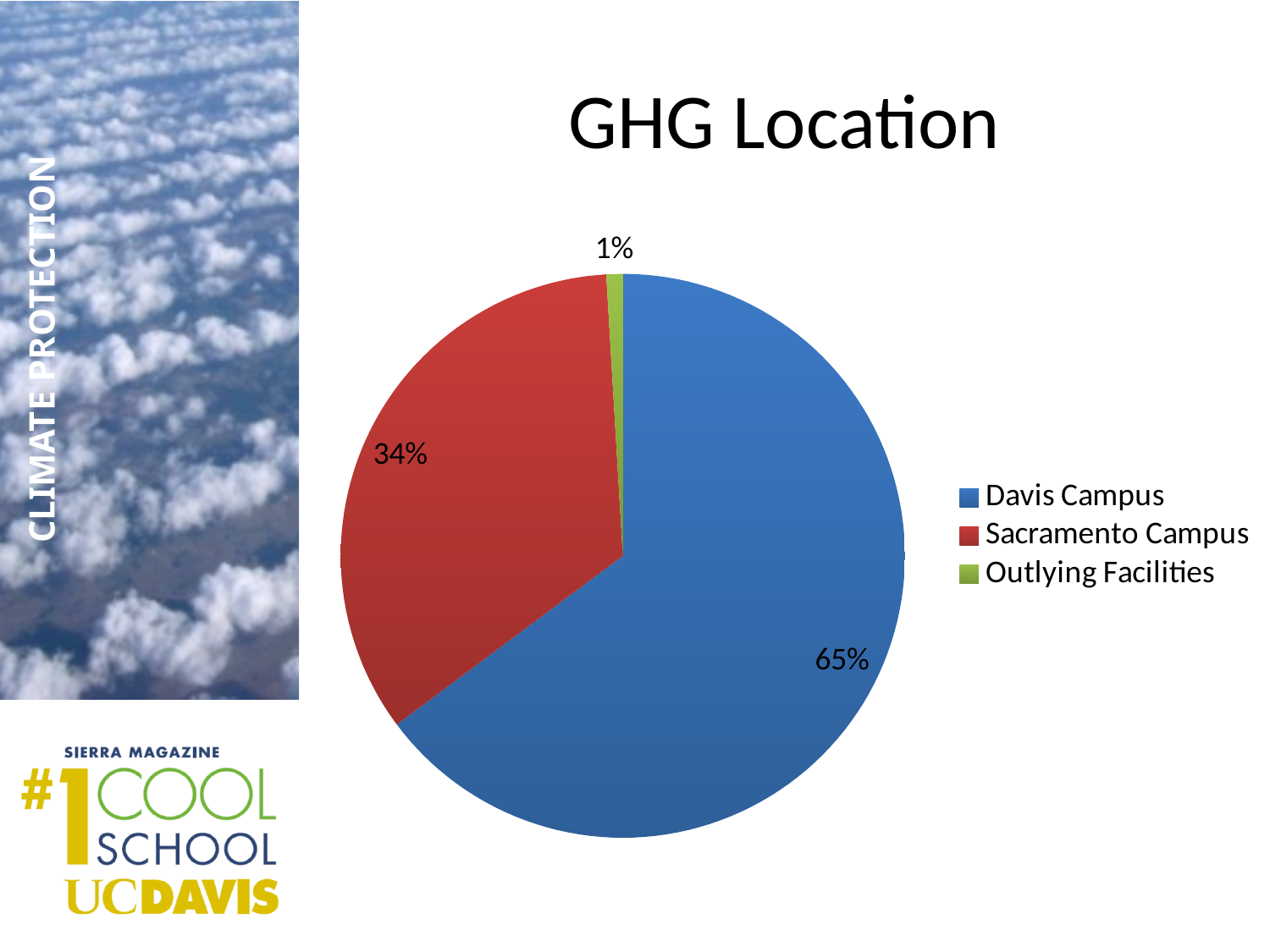
What share of the pie does Outlying Facilities account for? 1% Which category has the largest slice of the pie? Davis Campus What colour is the slice for Sacramento Campus? Red What is the title of the chart? GHG Location How many entries does the legend list? 3 Which category has the smallest slice of the pie? Outlying Facilities What is the difference in percentage points between Davis Campus and Sacramento Campus? 31 What kind of chart is shown on the slide? Pie chart What share of the pie does Davis Campus account for? 65% Which is larger, the share for Sacramento Campus or the share for Outlying Facilities? Sacramento Campus How many categories are shown in the pie chart? 3 What share of the pie does Sacramento Campus account for? 34%